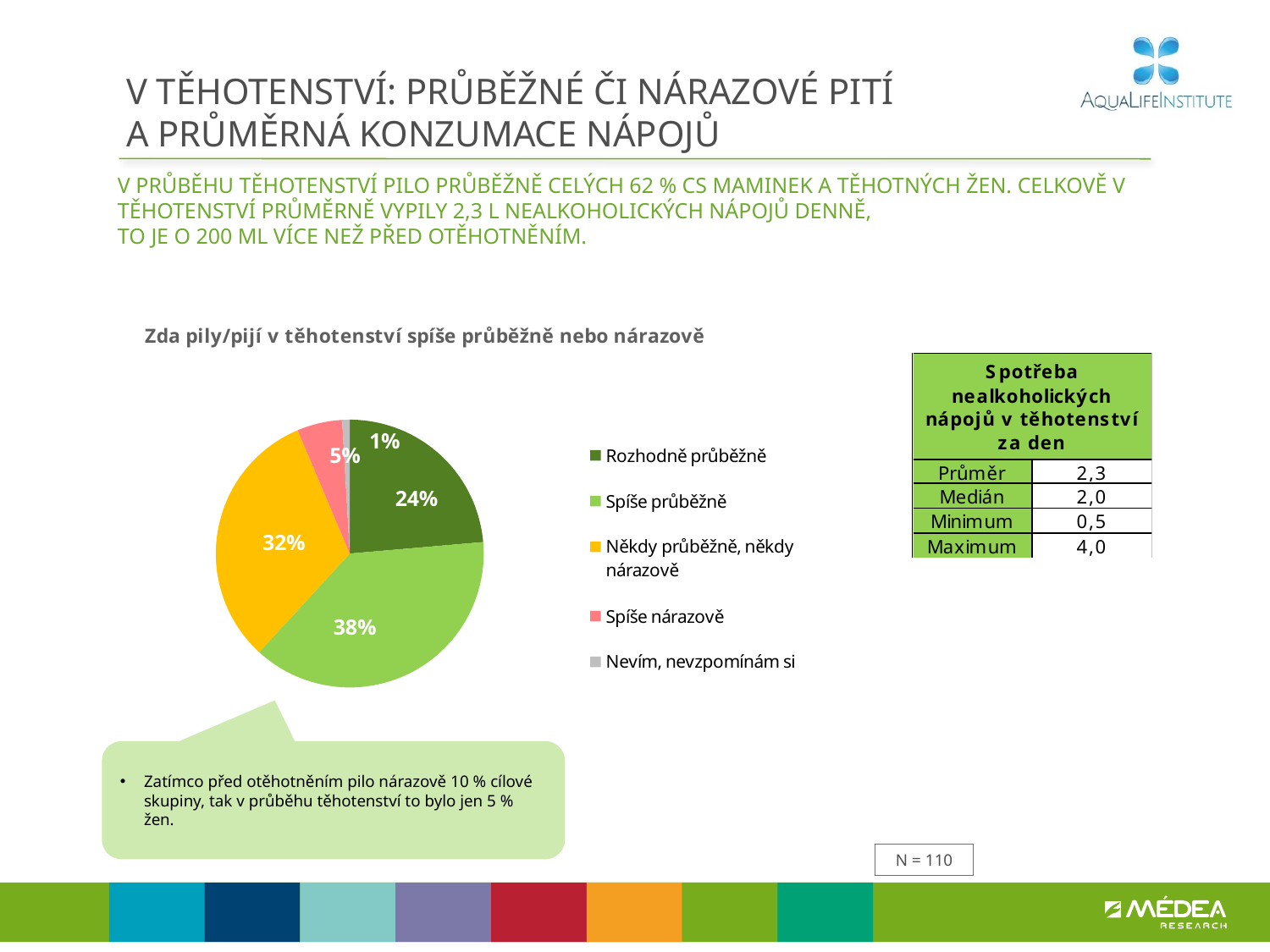
What is the difference between the shares of "Spíše průběžně" and "Rozhodně průběžně"? 14% Which category has the largest slice of the pie? Spíše průběžně What kind of chart is shown on the slide? pie chart How many categories does the legend of the pie chart list? 5 What is the value for "Někdy průběžně, někdy nárazově"? 32% What is the value for "Rozhodně průběžně" in the pie chart? 24% What is the value for "Spíše nárazově"? 5% Which is larger: the share for "Někdy průběžně, někdy nárazově" or for "Rozhodně průběžně"? Někdy průběžně, někdy nárazově What share of the pie does "Spíše průběžně" represent? 38% What is the value for "Nevím, nevzpomínám si"? 1% What is the title of the pie chart? Zda pily/pijí v těhotenství spíše průběžně nebo nárazově Which category has the smallest slice of the pie? Nevím, nevzpomínám si